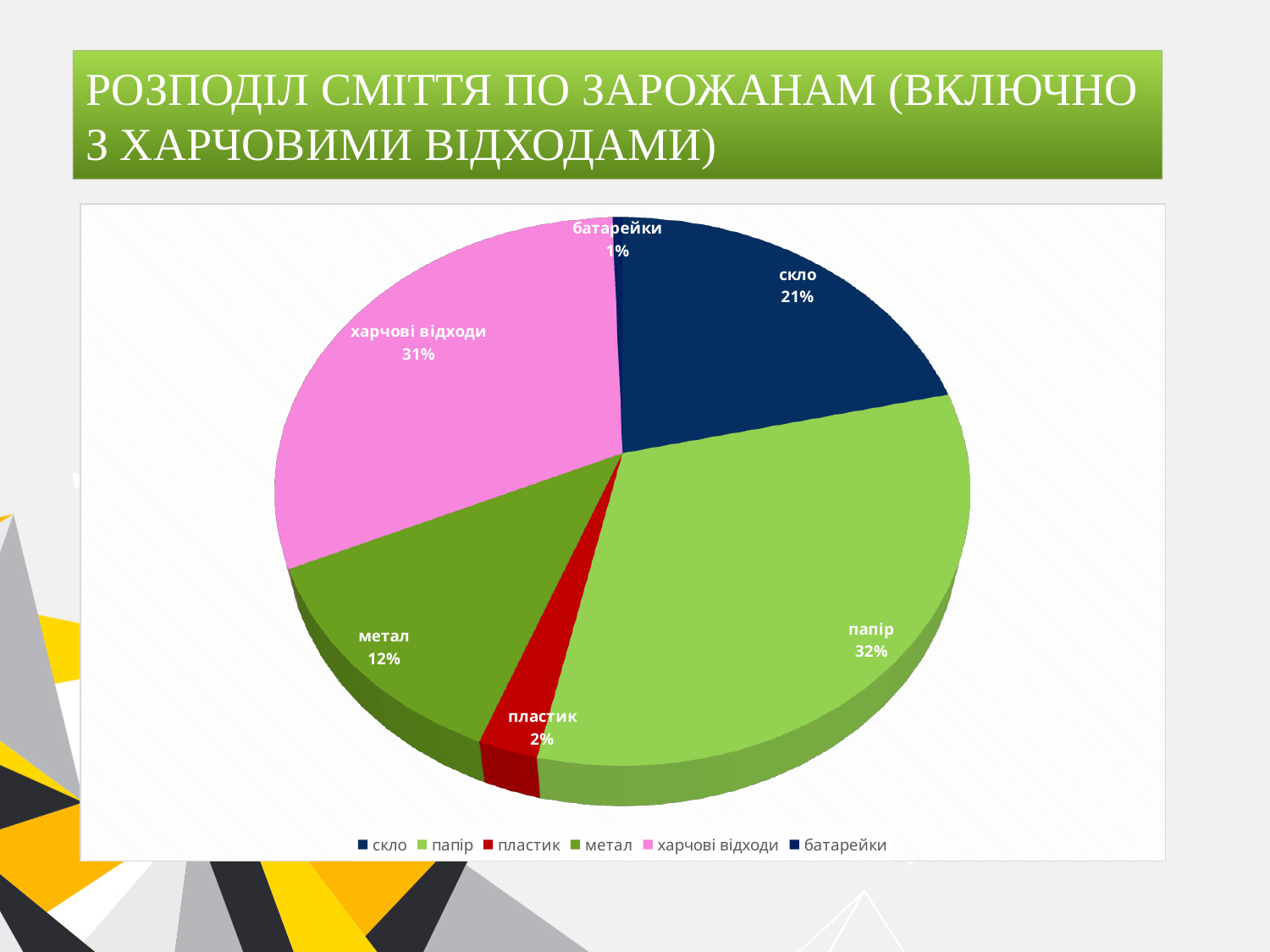
Which has a larger share, скло or харчові відходи? харчові відходи What share of the pie does метал have? 12% What share of the pie does батарейки have? 1% What share of the pie does харчові відходи have? 31% How many categories does the legend list? 6 What share of the pie does пластик have? 2% What share of the pie does скло have? 21% Which category has the smallest share of the pie? батарейки What is the difference between the shares of скло and метал? 9% What share of the pie does папір have? 32% What kind of chart is shown on the slide? pie chart Which category has the largest share of the pie? папір